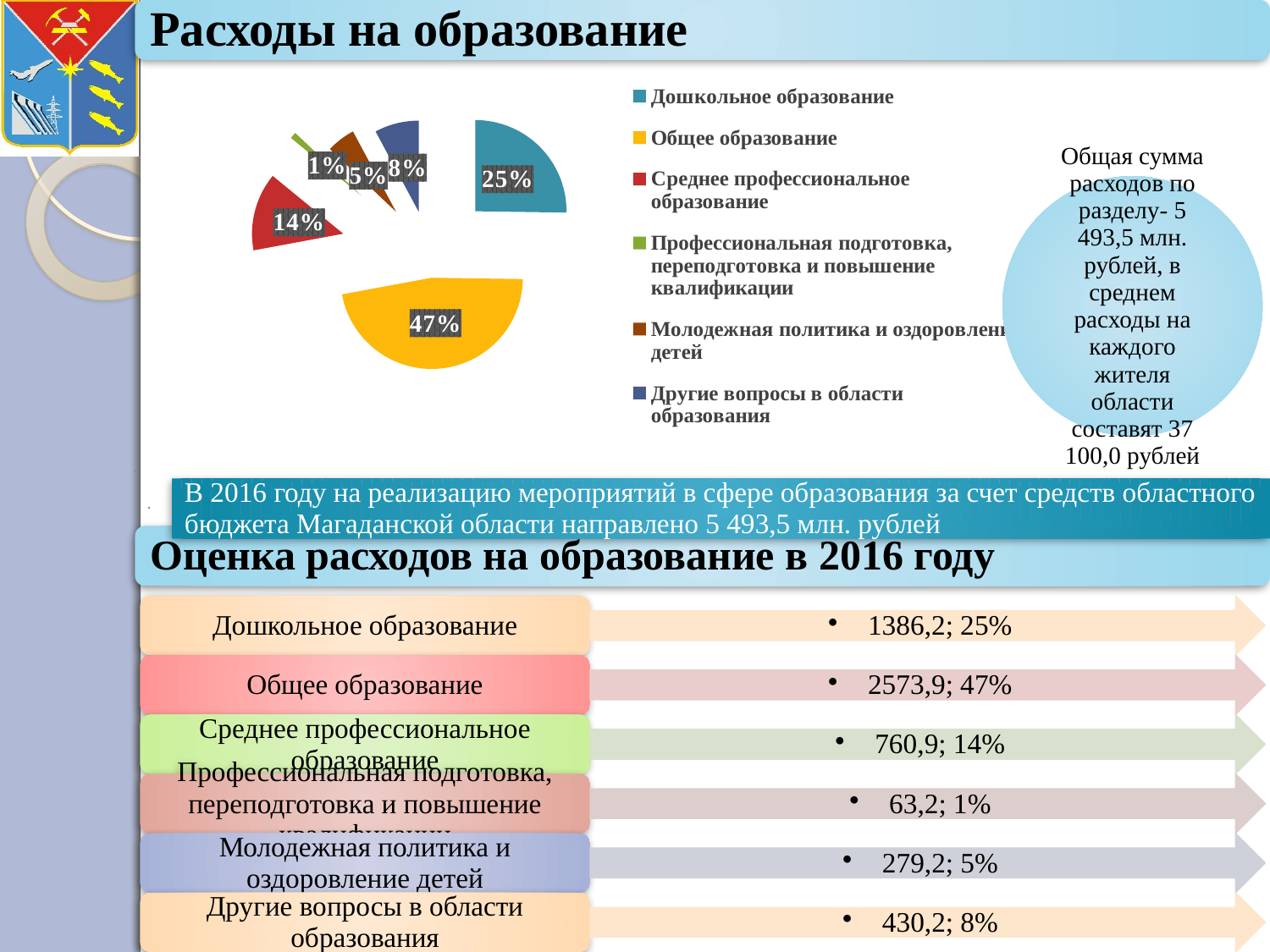
What share of the pie chart does Дошкольное образование have? 25% What share of the pie chart does Общее образование have? 47% What share of the pie chart does Молодежная политика и оздоровление детей have? 5% Which slice is larger: Среднее профессиональное образование or Другие вопросы в области образования? Среднее профессиональное образование Which category has the smallest slice in the pie chart? Профессиональная подготовка, переподготовка и повышение квалификации How many slices does the pie chart have? 6 What is the difference in percentage points between the slices for Общее образование and Дошкольное образование? 22 What colour is the slice for Общее образование in the pie chart? yellow Which category has the largest slice in the pie chart? Общее образование What kind of chart is shown on the slide? pie chart